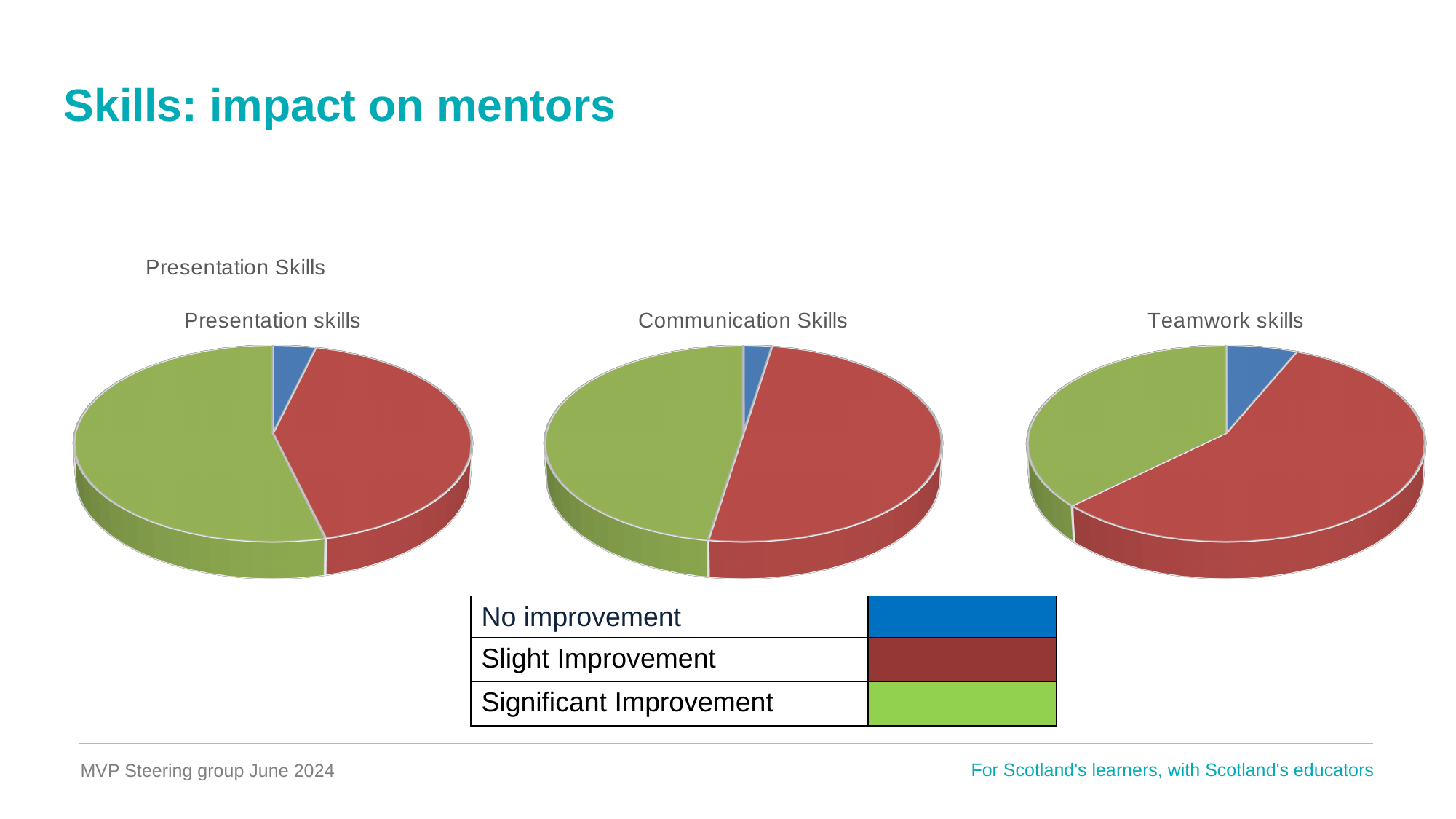
What kind of chart is used for Presentation skills? pie chart What is the title of the rightmost pie chart? Teamwork skills In the Teamwork skills chart, which category has the largest slice? Slight Improvement How many categories does the legend list? 3 How many pie charts are shown on the slide? 3 In the Presentation skills chart, which category has the smallest slice? No improvement Which colour represents Slight Improvement in the legend? red In the Presentation skills chart, which slice is larger: Significant Improvement or No improvement? Significant Improvement In the Teamwork skills chart, which category has the smallest slice? No improvement In the Teamwork skills chart, which slice is larger: Slight Improvement or Significant Improvement? Slight Improvement In the Communication Skills chart, which category has the smallest slice? No improvement In the Presentation skills chart, which category has the largest slice? Significant Improvement